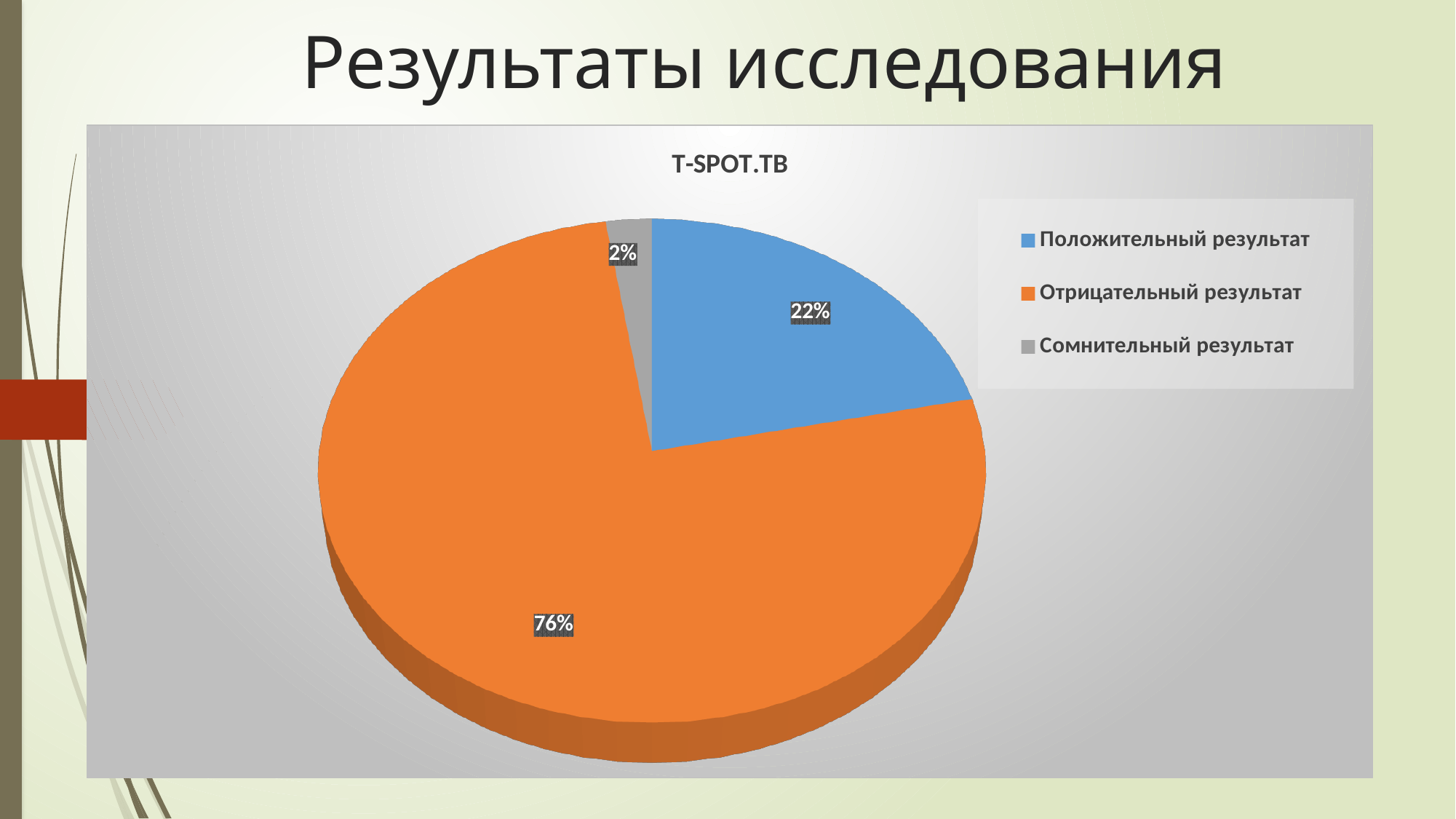
What is the difference in percentage points between Отрицательный результат and Положительный результат? 54 Which is larger, the slice for Положительный результат or the slice for Сомнительный результат? Положительный результат What type of chart is shown on the slide? Pie chart How many slices does the pie chart have? 3 What share of the pie is labelled for Отрицательный результат? 76% What share of the pie is labelled for Положительный результат? 22% How many entries does the legend list? 3 Which category has the smallest slice of the pie? Сомнительный результат What share of the pie is labelled for Сомнительный результат? 2% What is the title of the chart? T-SPOT.TB Which category has the largest slice of the pie? Отрицательный результат What colour is the slice for Отрицательный результат? Orange